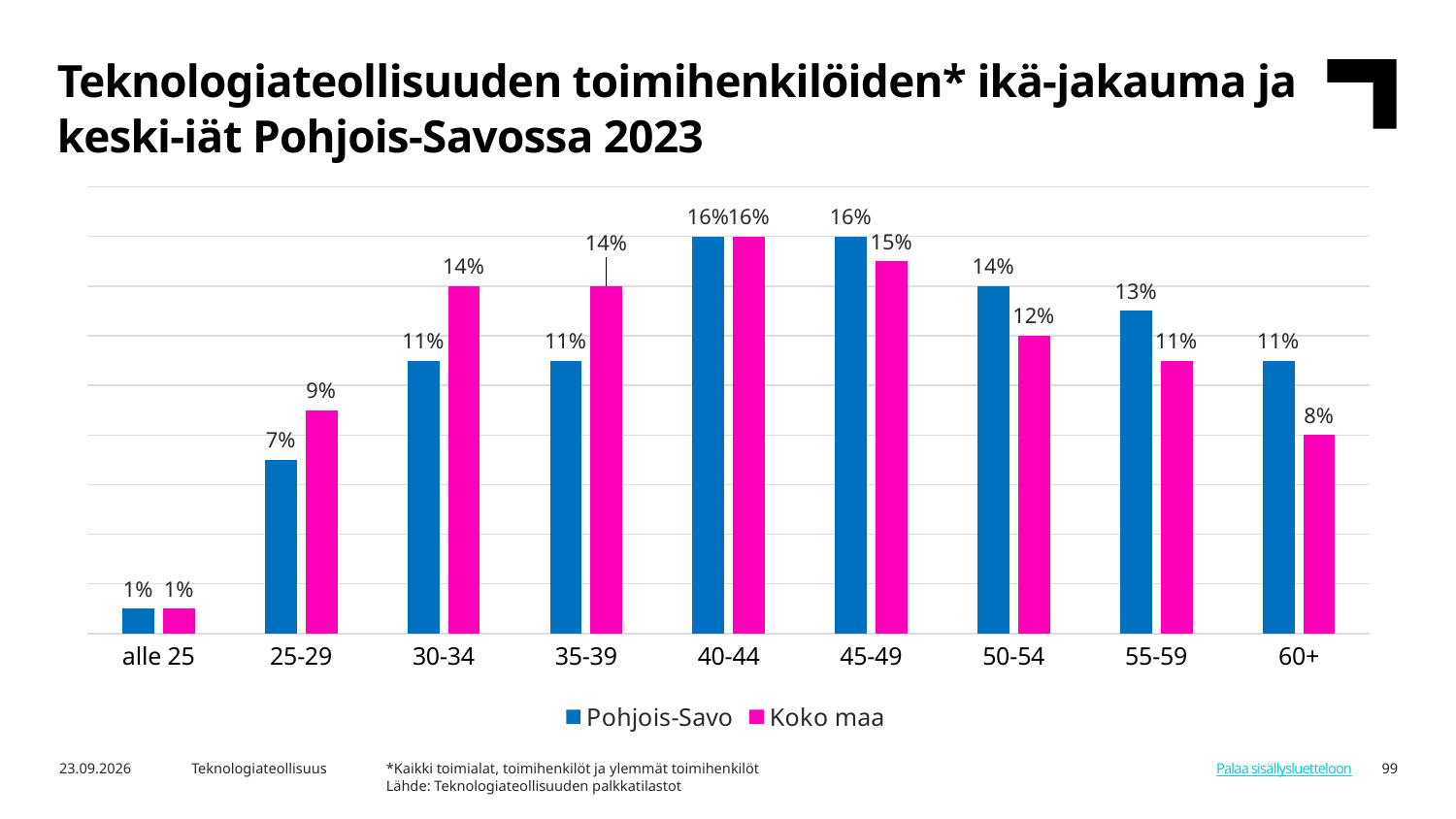
How many series does the legend list? 2 Which age group has the highest Koko maa value? 40-44 What is the difference between the Pohjois-Savo and Koko maa values for the 60+ age group? 3% What kind of chart is shown on the slide? Bar chart What is the Pohjois-Savo value for the 25-29 age group? 7% What is the Koko maa value for the 60+ age group? 8% For the 25-29 age group, which is larger: Pohjois-Savo or Koko maa? Koko maa What is the Pohjois-Savo value for the 50-54 age group? 14% How many age groups are shown on the x axis? 9 Which age group has the lowest Pohjois-Savo value? alle 25 What is the difference between the Koko maa and Pohjois-Savo values for the 30-34 age group? 3% For the 55-59 age group, which is larger: Pohjois-Savo or Koko maa? Pohjois-Savo